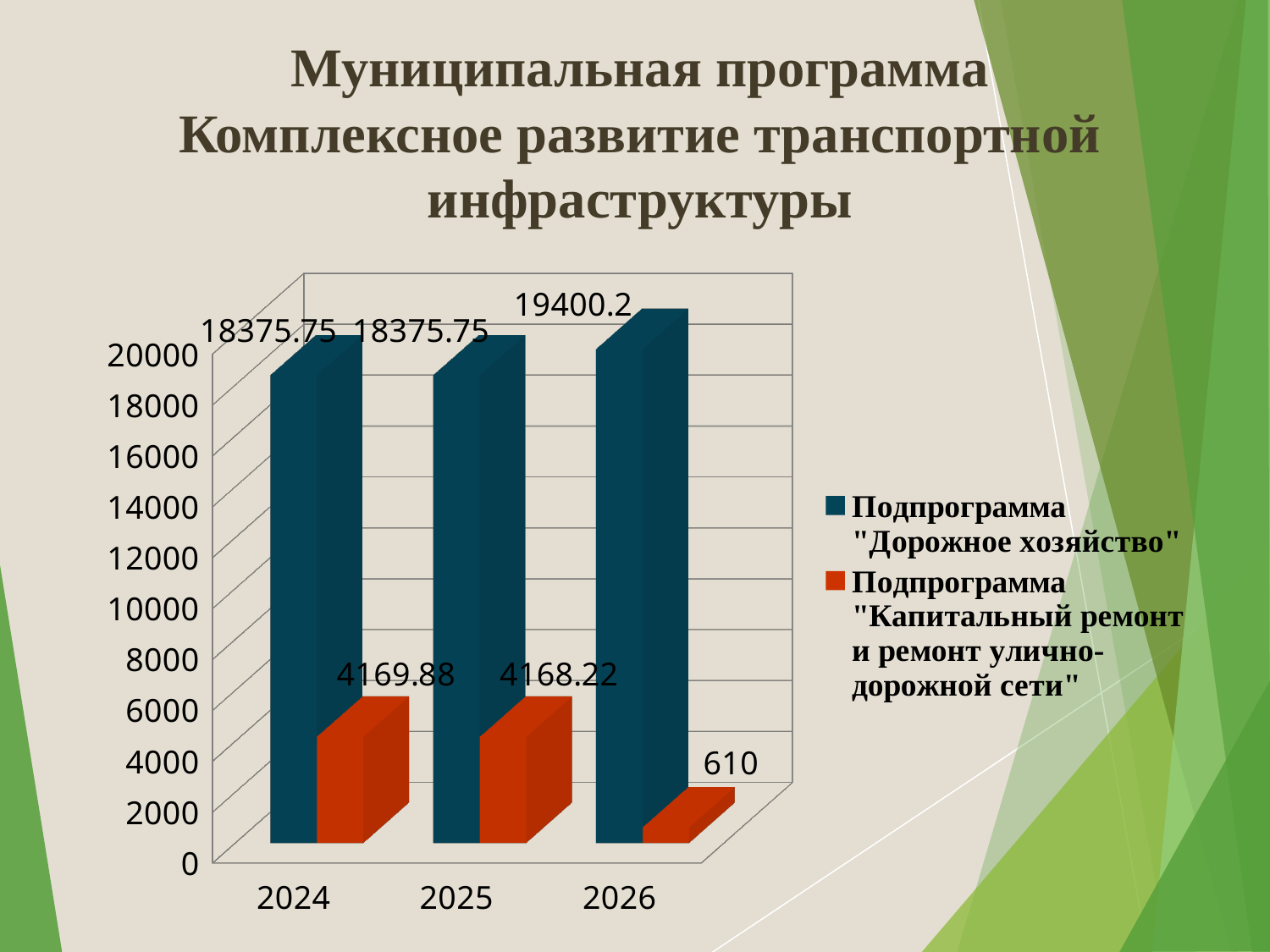
In which year is the value for Подпрограмма "Капитальный ремонт и ремонт улично-дорожной сети" lowest? 2026 Which is larger in 2025: Подпрограмма "Дорожное хозяйство" or Подпрограмма "Капитальный ремонт и ремонт улично-дорожной сети"? Подпрограмма "Дорожное хозяйство" In which year is the value for Подпрограмма "Дорожное хозяйство" highest? 2026 What is the value for Подпрограмма "Капитальный ремонт и ремонт улично-дорожной сети" in 2024? 4169.88 What is the value for Подпрограмма "Дорожное хозяйство" in 2026? 19400.2 Does the value for Подпрограмма "Капитальный ремонт и ремонт улично-дорожной сети" rise or fall from 2024 to 2026? Fall How many years are shown on the x axis? 3 What is the difference between the 2026 and 2025 values for Подпрограмма "Дорожное хозяйство"? 1024.45 What kind of chart is shown on the slide? Bar chart What is the value for Подпрограмма "Капитальный ремонт и ремонт улично-дорожной сети" in 2026? 610 What is the value for Подпрограмма "Дорожное хозяйство" in 2024? 18375.75 How many series does the legend list? 2